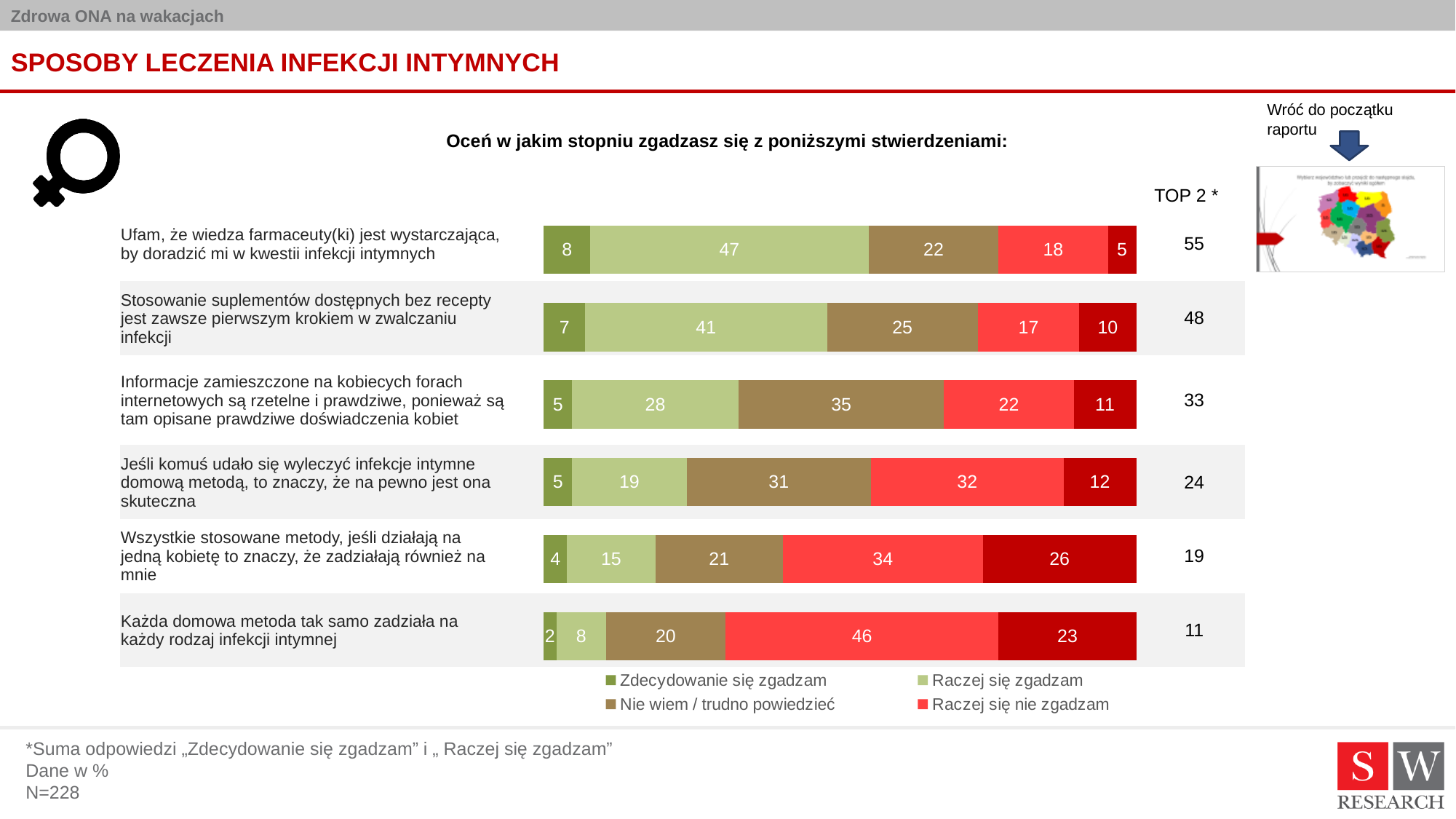
What is the difference between the 'Raczej się nie zgadzam' values for 'Każda domowa metoda tak samo zadziała na każdy rodzaj infekcji intymnej' and 'Wszystkie stosowane metody, jeśli działają na jedną kobietę...'? 12 What kind of chart is shown on the slide? Stacked bar chart What is the 'Nie wiem / trudno powiedzieć' value for the statement 'Informacje zamieszczone na kobiecych forach internetowych są rzetelne i prawdziwe...'? 35 Which statement has the highest TOP 2 value? Ufam, że wiedza farmaceuty(ki) jest wystarczająca, by doradzić mi w kwestii infekcji intymnych What is the total of the stacked bar for 'Ufam, że wiedza farmaceuty(ki) jest wystarczająca...' (8 + 47 + 22 + 18 + 5)? 100 Which statement has the lowest TOP 2 value? Każda domowa metoda tak samo zadziała na każdy rodzaj infekcji intymnej What is the TOP 2 value for the statement 'Stosowanie suplementów dostępnych bez recepty jest zawsze pierwszym krokiem w zwalczaniu infekcji'? 48 What is the sample size (N) stated on the slide? N=228 What is the 'Raczej się zgadzam' value for the statement 'Ufam, że wiedza farmaceuty(ki) jest wystarczająca, by doradzić mi w kwestii infekcji intymnych'? 47 How many series does the legend list? 4 Which is larger: the 'Raczej się zgadzam' value for 'Jeśli komuś udało się wyleczyć infekcje intymne domową metodą...' or for 'Wszystkie stosowane metody, jeśli działają na jedną kobietę...'? Jeśli komuś udało się wyleczyć infekcje intymne domową metodą... How many statements (categories) are plotted in the chart? 6